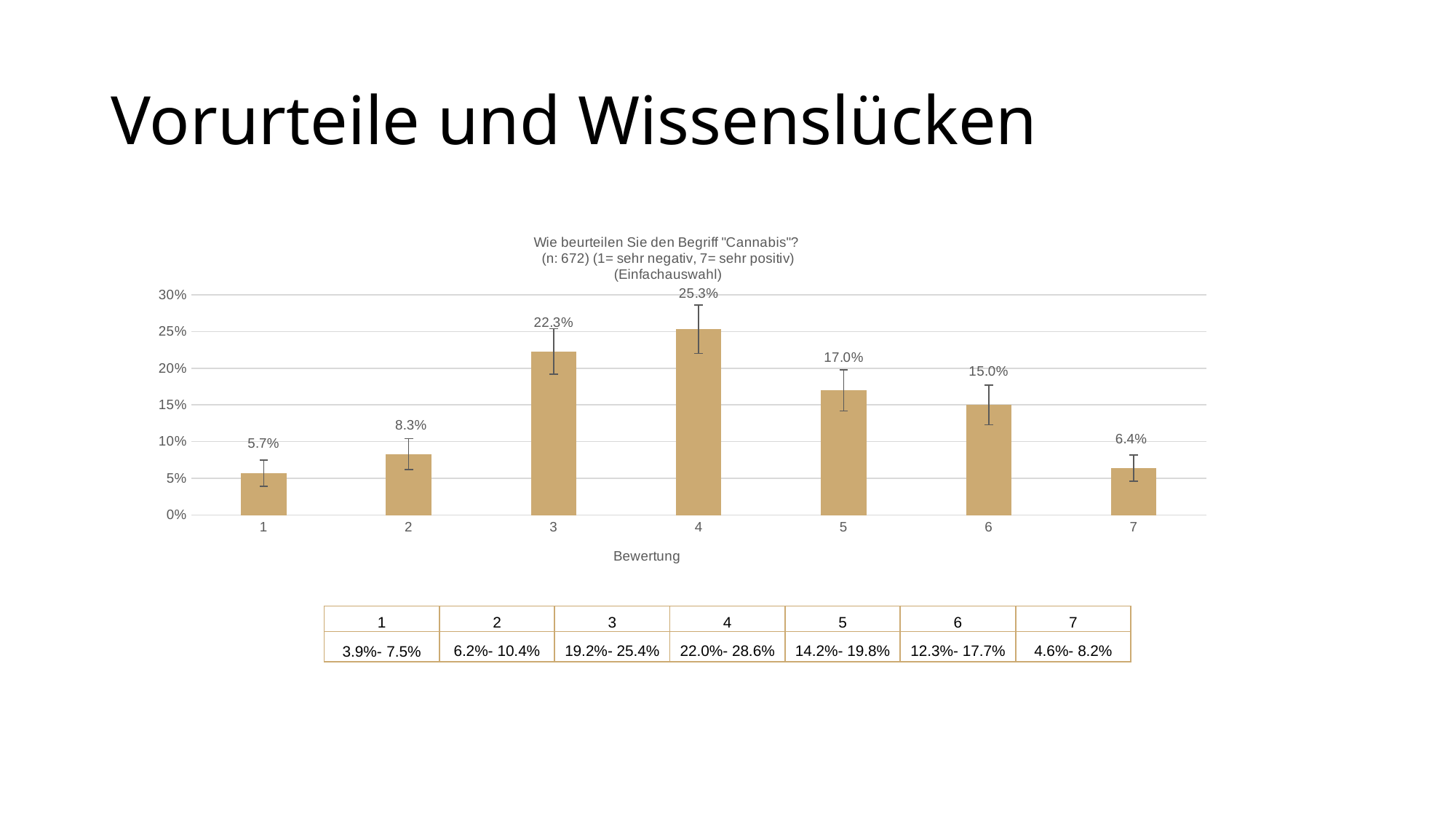
Which rating has the highest value? 4 What is the difference between the values for rating 5 and rating 2? 8.7% What kind of chart is shown? bar chart What is the value for rating 6? 15.0% What is the x-axis title of the chart? Bewertung What is the value for rating 4? 25.3% What is the value for rating 1? 5.7% Is the value for rating 3 greater or less than 20%? greater What is the difference between the values for rating 4 and rating 3? 3.0% Which is larger, the value for rating 5 or the value for rating 6? 5 How many rating categories are shown on the x axis? 7 Which rating has the lowest value? 1